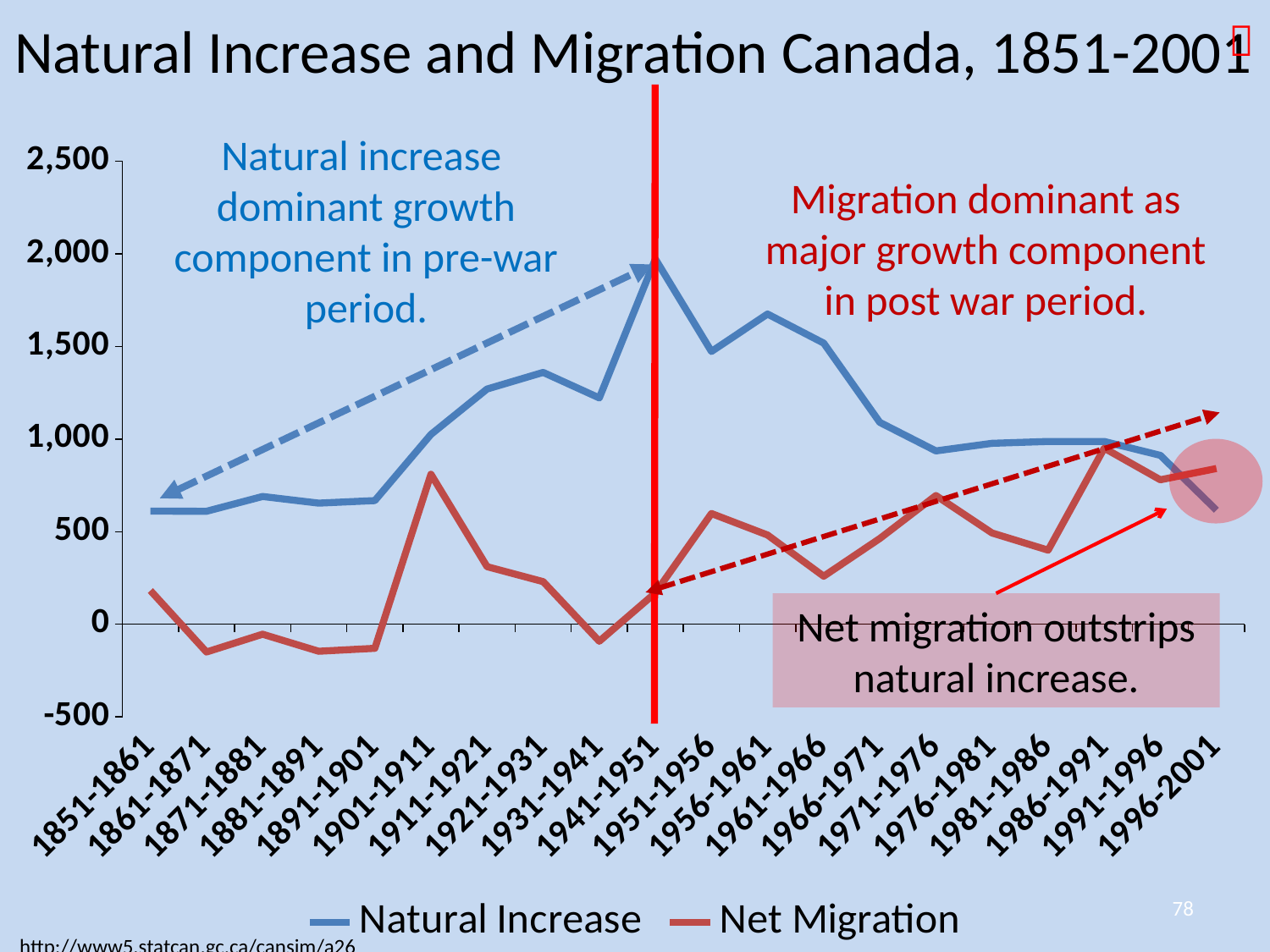
Is the Natural Increase value for 1941-1951 greater or less than 1,500? greater Which series has the larger value in 1996-2001, Natural Increase or Net Migration? Net Migration In which period does Natural Increase reach its highest value? 1941-1951 Is the Net Migration value for 1931-1941 greater or less than 0? less Does Natural Increase generally rise or fall from 1951-1956 to 1996-2001? Fall What are the two series named in the legend? Natural Increase and Net Migration Which series has the larger value in 1941-1951, Natural Increase or Net Migration? Natural Increase Is the Net Migration value for 1901-1911 greater or less than 500? greater How many time periods are shown along the x axis? 20 How many series does the legend list? 2 What kind of chart is shown on the slide? Line chart In which period does Net Migration reach its highest value? 1986-1991